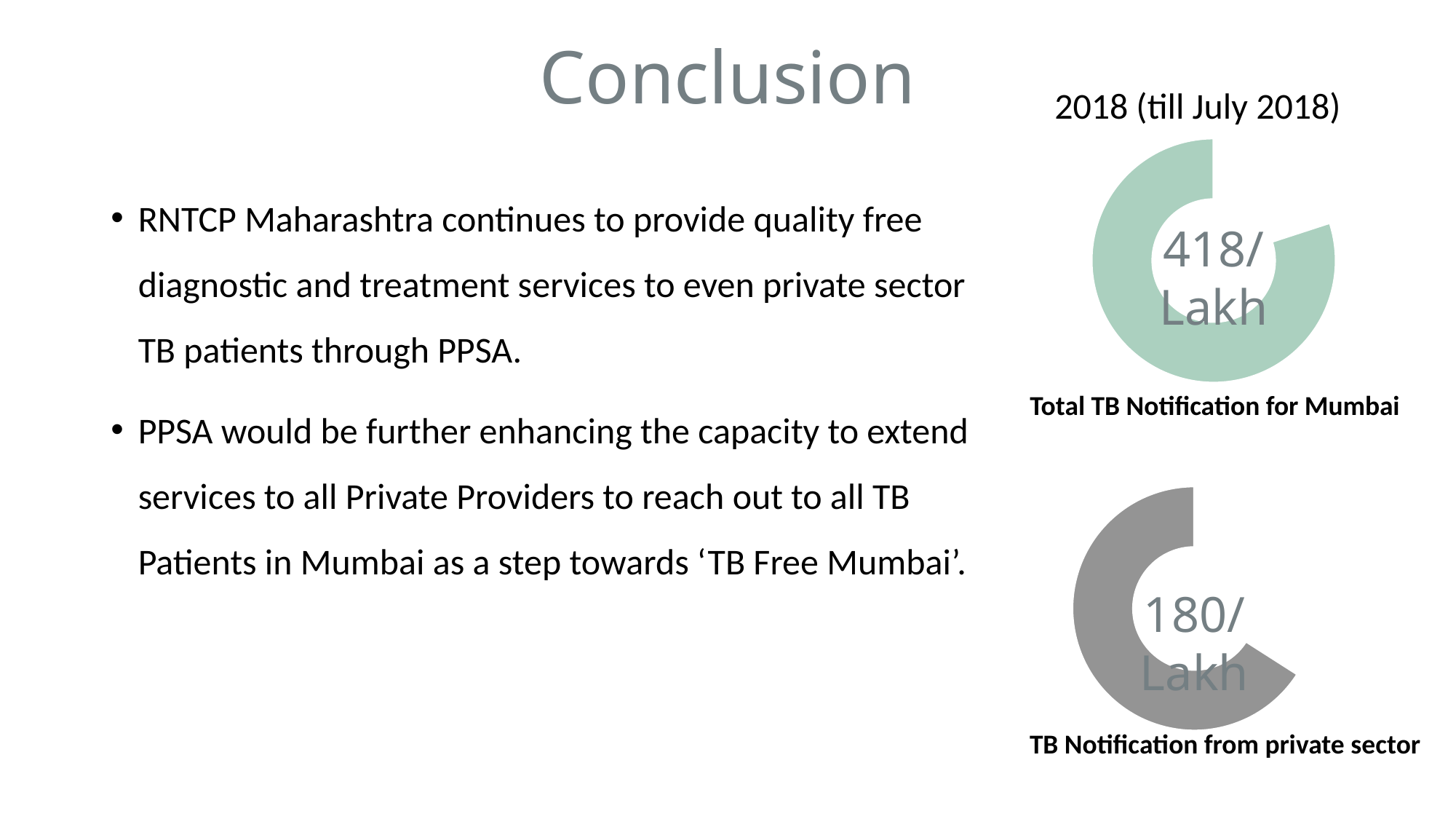
How many donut charts are shown on the slide? 2 Is the TB Notification from private sector greater or less than 200/Lakh? less What colour is the donut chart for TB Notification from private sector? Grey What time period is stated above the charts on the slide? 2018 (till July 2018) What value is shown in the centre of the 'Total TB Notification for Mumbai' chart? 418/Lakh Is the Total TB Notification for Mumbai greater or less than 400/Lakh? greater What value is shown in the centre of the 'TB Notification from private sector' chart? 180/Lakh Which is larger, the Total TB Notification for Mumbai or the TB Notification from private sector? Total TB Notification for Mumbai What is the difference between the Total TB Notification for Mumbai (418/Lakh) and the TB Notification from private sector (180/Lakh)? 238/Lakh What kind of chart is used to show the Total TB Notification for Mumbai? Donut chart